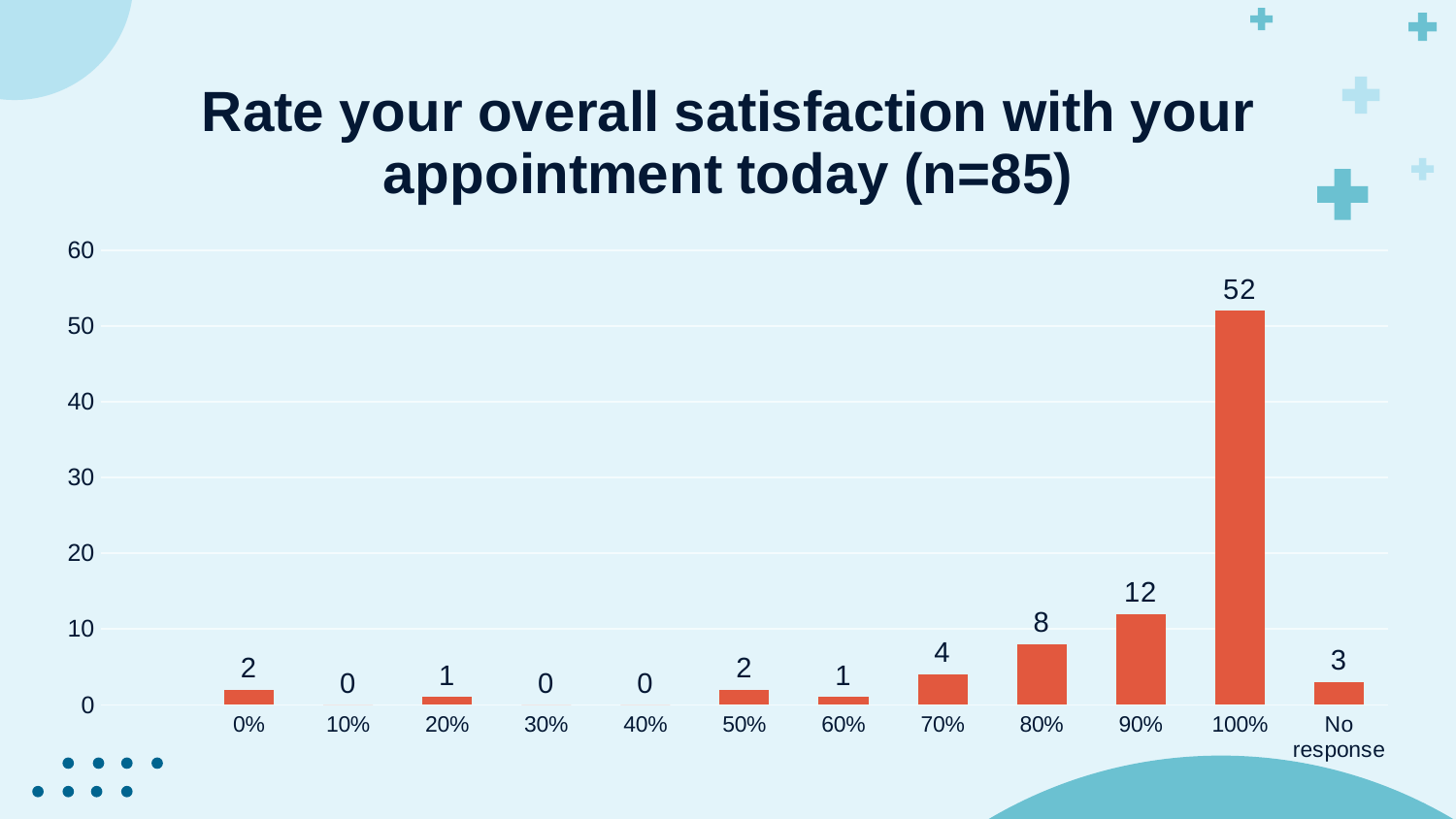
How many categories are shown on the x axis? 12 What is the difference between the values for 80% and 50%? 6 How many respondents rated their satisfaction at 100%? 52 How many respondents gave no response? 3 What is the value for the 90% category? 12 What is the value for the 70% category? 4 What kind of chart is shown on the slide? Bar chart What is the difference between the values for 100% and 90%? 40 Which category has the highest value? 100% How many categories have a value of 0? 3 What is the title of the chart? Rate your overall satisfaction with your appointment today (n=85) Which is larger, the value for 80% or the value for 70%? 80%